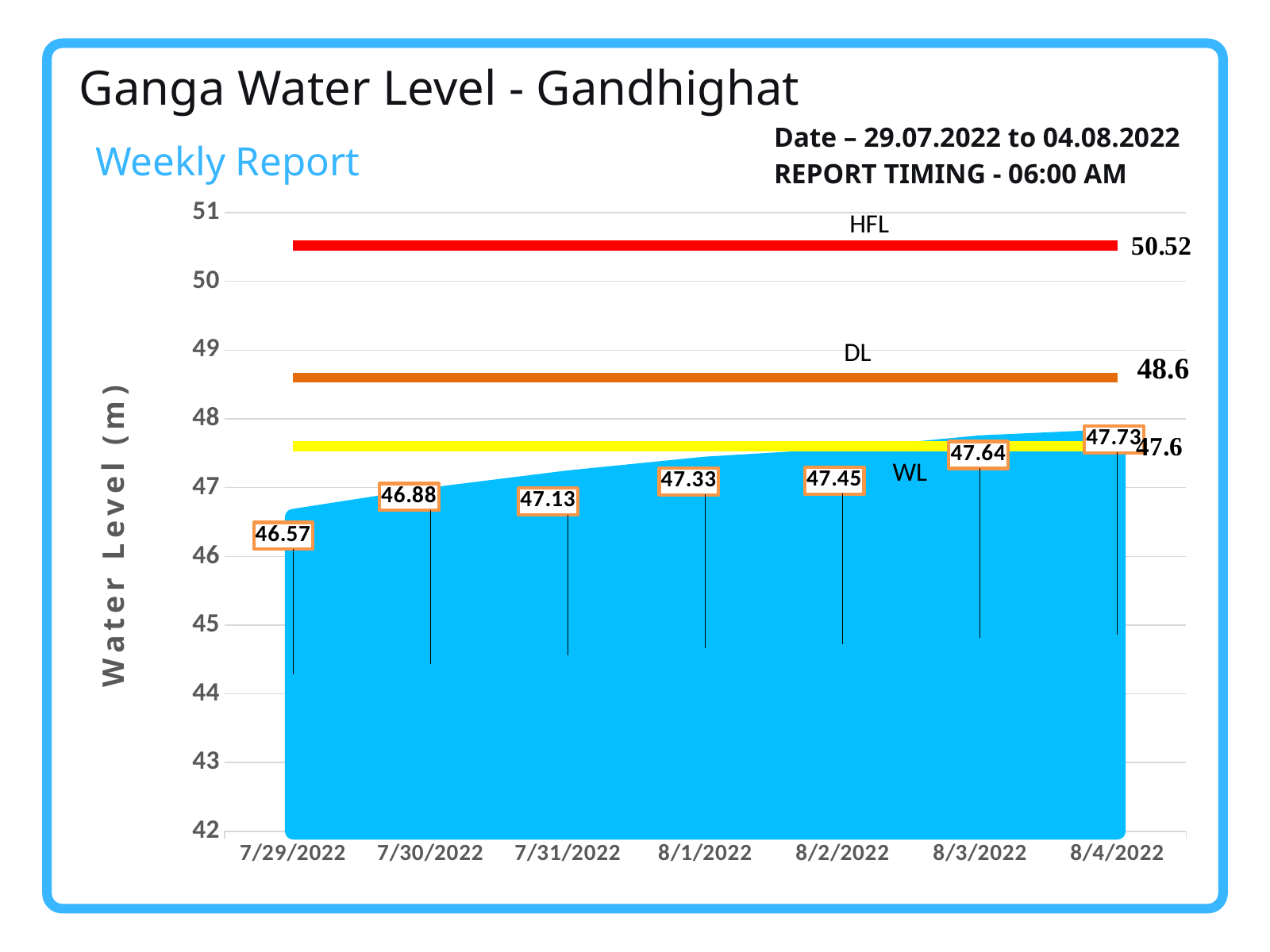
How many dates are plotted on the x axis? 7 What is the water level on 8/4/2022? 47.73 Which date has a higher water level, 7/31/2022 or 8/3/2022? 8/3/2022 What is the difference between the water level on 8/4/2022 and on 7/29/2022? 1.16 What is the water level on 8/2/2022? 47.45 Does the water level rise or fall from 7/29/2022 to 8/4/2022? rise What is the water level on 7/29/2022? 46.57 What value is shown for the HFL line? 50.52 On which date is the water level lowest? 7/29/2022 On which date is the water level highest? 8/4/2022 What value is shown for the DL line? 48.6 What is the title of the chart's vertical axis? Water Level (m)